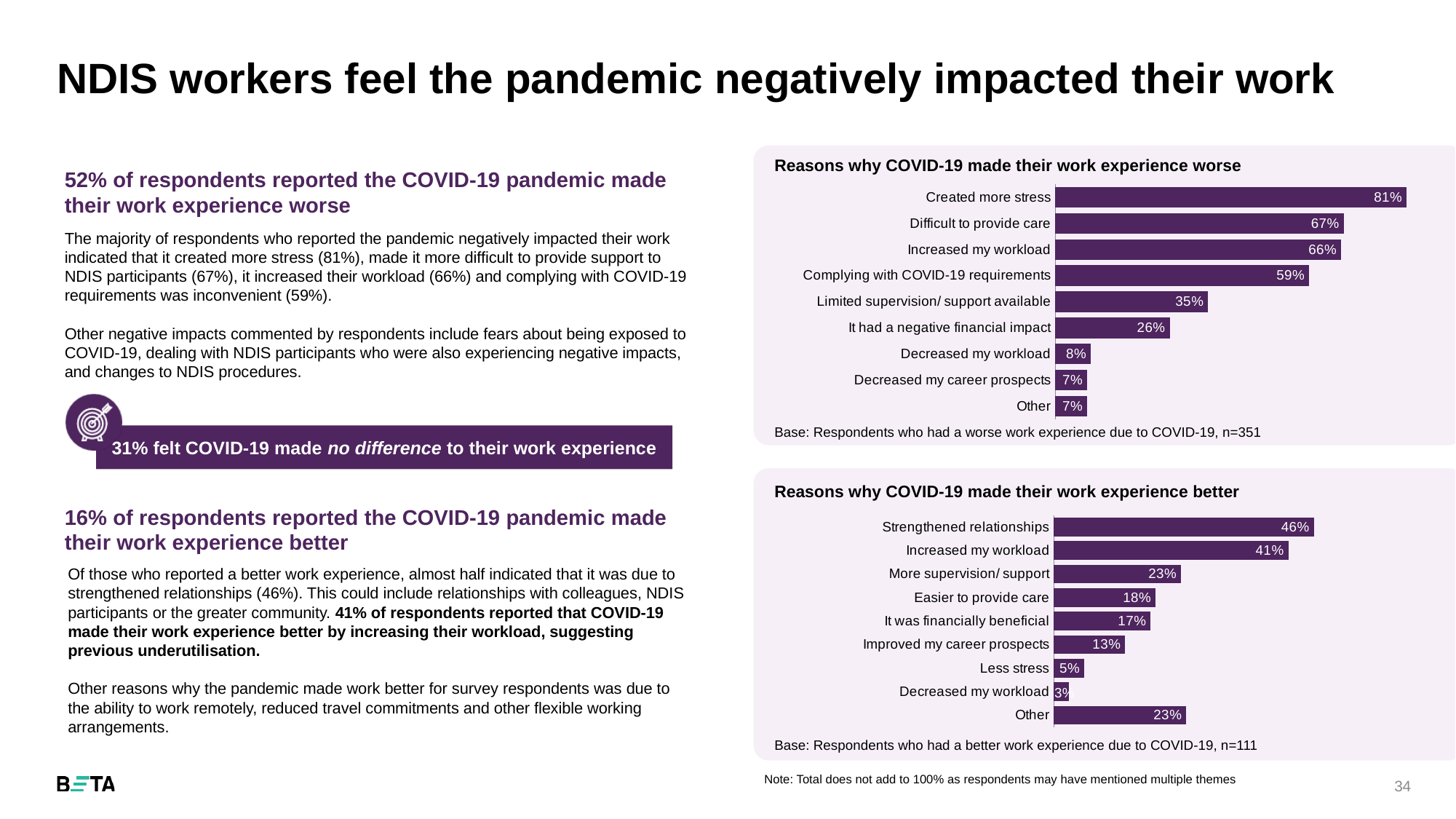
In the 'Reasons why COVID-19 made their work experience better' chart, which is larger: 'Easier to provide care' or 'It was financially beneficial'? Easier to provide care In the 'Reasons why COVID-19 made their work experience better' chart, what is the difference between 'Strengthened relationships' and 'Increased my workload'? 5% What kind of chart is the 'Reasons why COVID-19 made their work experience better' chart? Bar chart In the 'Reasons why COVID-19 made their work experience better' chart, what is the value for 'Improved my career prospects'? 13% In the 'Reasons why COVID-19 made their work experience better' chart, which reason has the lowest value? Decreased my workload What is the base (n) stated for the 'Reasons why COVID-19 made their work experience worse' chart? n=351 In the 'Reasons why COVID-19 made their work experience worse' chart, which reason has the highest value? Created more stress In the 'Reasons why COVID-19 made their work experience worse' chart, what is the value for 'Limited supervision/ support available'? 35% In the 'Reasons why COVID-19 made their work experience worse' chart, how many reasons are listed? 9 In the 'Reasons why COVID-19 made their work experience worse' chart, what is the difference between 'Difficult to provide care' and 'Complying with COVID-19 requirements'? 8% In the 'Reasons why COVID-19 made their work experience worse' chart, what is the value for 'Created more stress'? 81% In the 'Reasons why COVID-19 made their work experience better' chart, what is the value for 'Strengthened relationships'? 46%